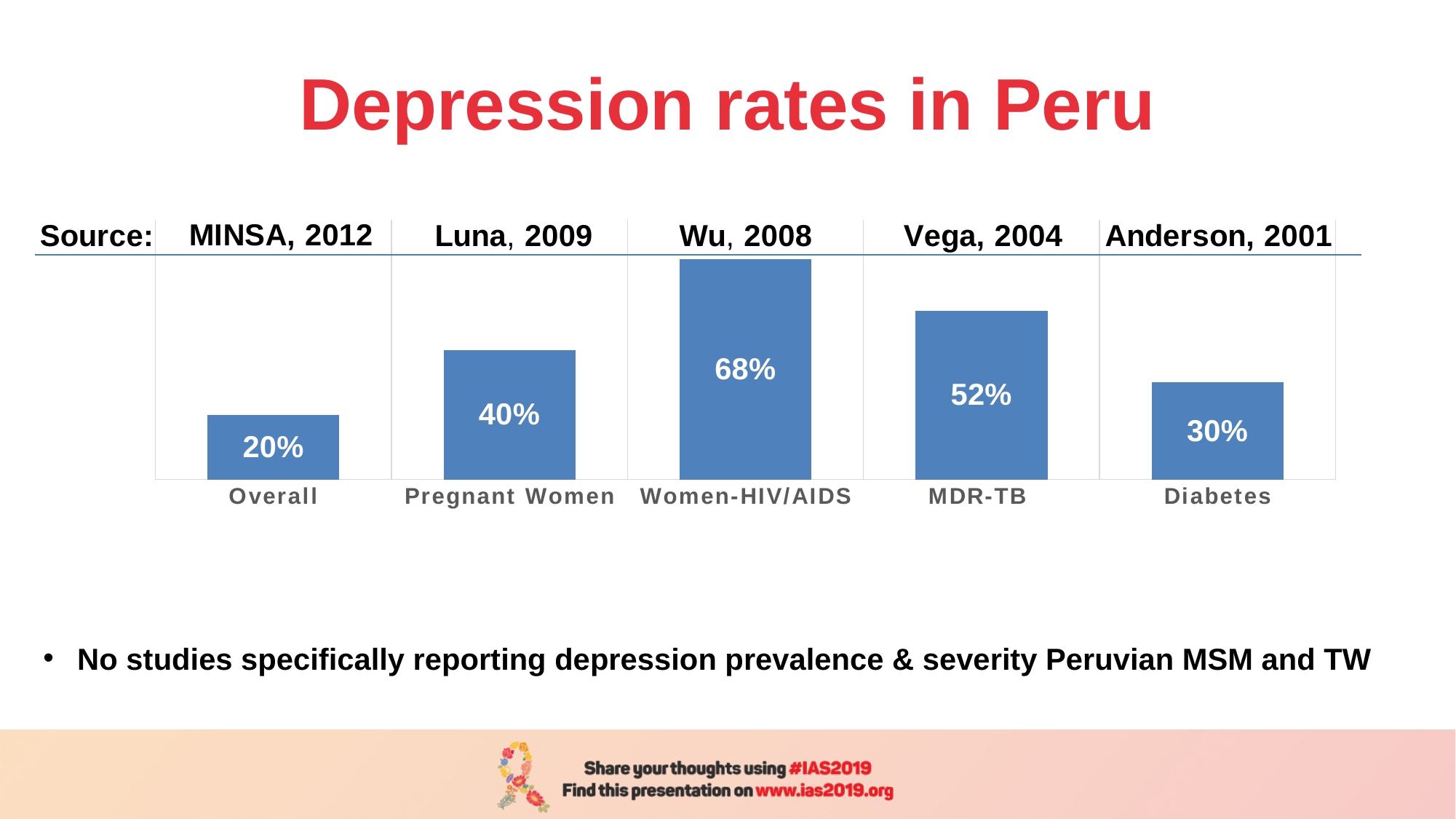
What is the difference between the depression rates for Women-HIV/AIDS and Overall? 48% Which category has the highest depression rate? Women-HIV/AIDS What is the depression rate shown for Pregnant Women? 40% What is the depression rate shown for Overall? 20% What is the depression rate shown for Diabetes? 30% Which source is listed above the Women-HIV/AIDS bar? Wu, 2008 Which has a higher depression rate, MDR-TB or Diabetes? MDR-TB Which category has the lowest depression rate? Overall What is the depression rate shown for Women-HIV/AIDS? 68% What kind of chart is shown on the slide? Bar chart How many categories are shown in the chart? 5 What is the depression rate shown for MDR-TB? 52%